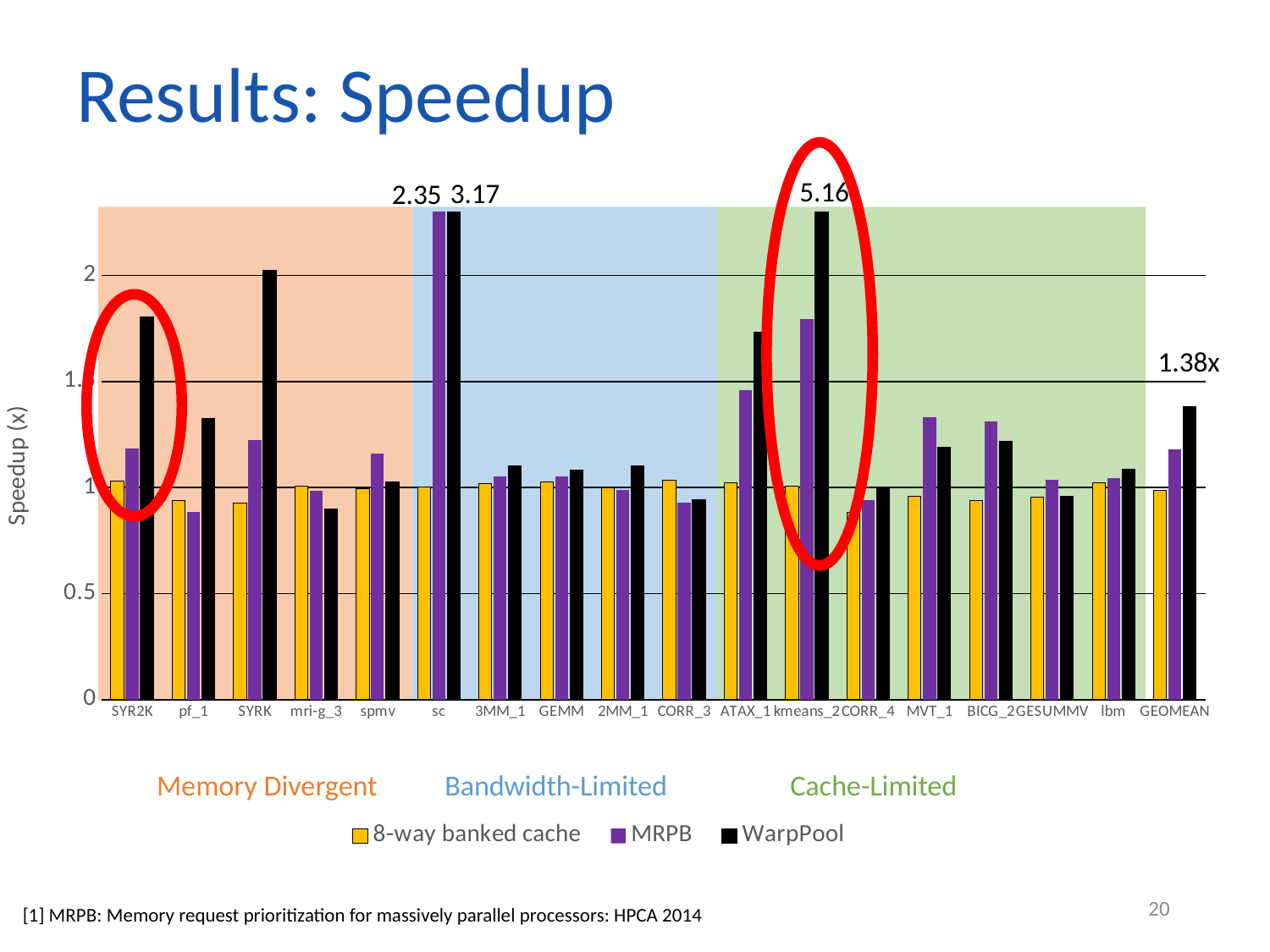
Is the WarpPool value for SYR2K greater or less than 1.5? greater Which category has the highest WarpPool speedup? kmeans_2 What is the WarpPool value labelled for GEOMEAN? 1.38x What kind of chart is shown on the slide? bar chart What is the WarpPool speedup for sc? 3.17 How many categories are shown along the x axis? 18 What is the WarpPool speedup for kmeans_2? 5.16 For sc, what is the difference between the WarpPool and MRPB speedups? 0.82 How many series does the legend list? 3 For SYR2K, which is larger: the MRPB bar or the WarpPool bar? WarpPool What colour are the WarpPool bars? black What is the MRPB speedup for sc? 2.35